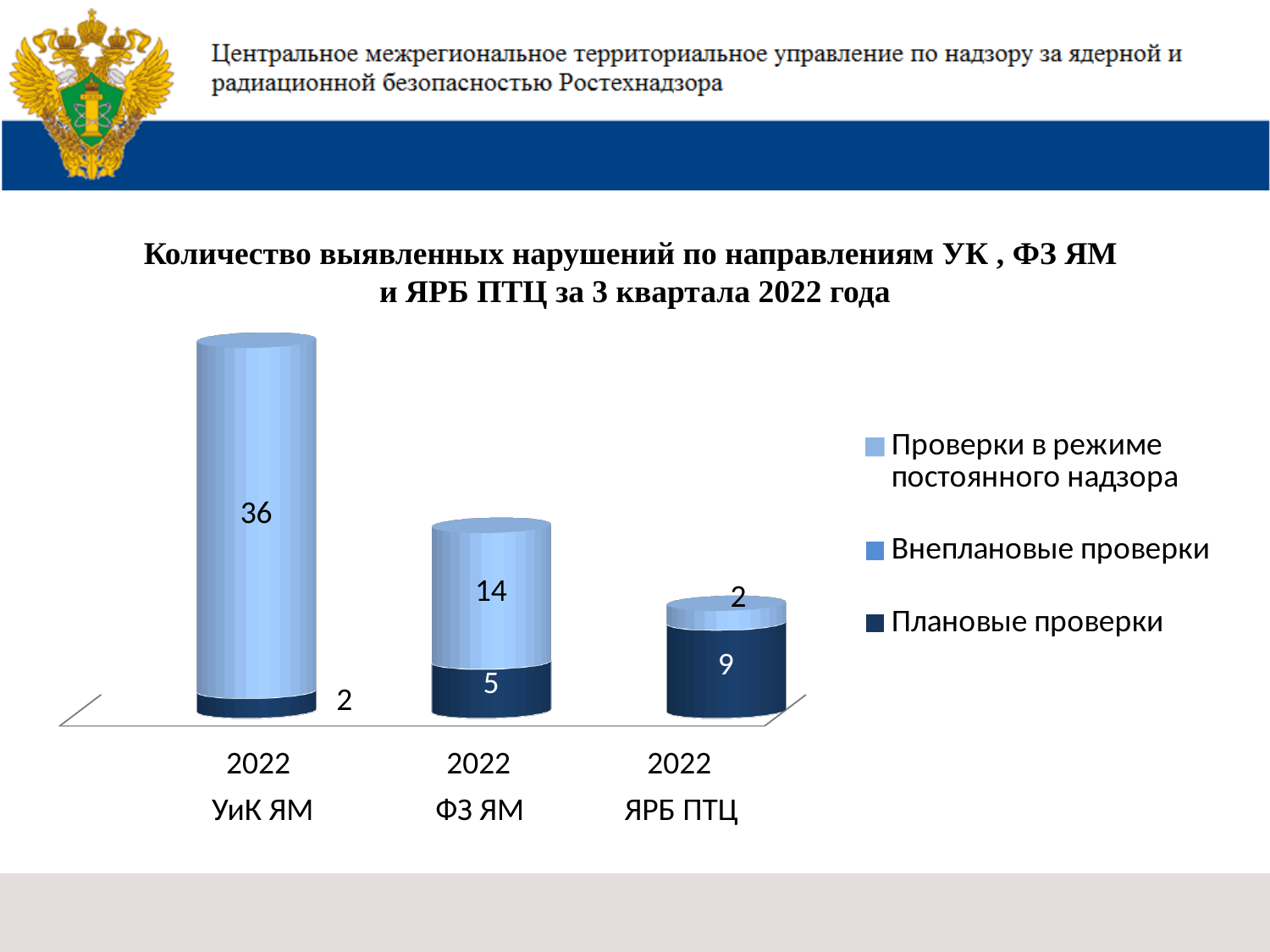
What type of chart is shown on the slide? bar chart What is the total of the stacked bar for ФЗ ЯМ? 19 Which category has the lowest value for Плановые проверки? УиК ЯМ How many series does the legend list? 3 Which is larger for ЯРБ ПТЦ: Плановые проверки or Проверки в режиме постоянного надзора? Плановые проверки How many categories are shown on the x axis? 3 What is the value of Проверки в режиме постоянного надзора for УиК ЯМ? 36 What is the value of Плановые проверки for ФЗ ЯМ? 5 What is the value of Проверки в режиме постоянного надзора for ФЗ ЯМ? 14 What is the difference between Проверки в режиме постоянного надзора for УиК ЯМ and for ФЗ ЯМ? 22 What is the value of Плановые проверки for ЯРБ ПТЦ? 9 Which category has the highest value for Проверки в режиме постоянного надзора? УиК ЯМ